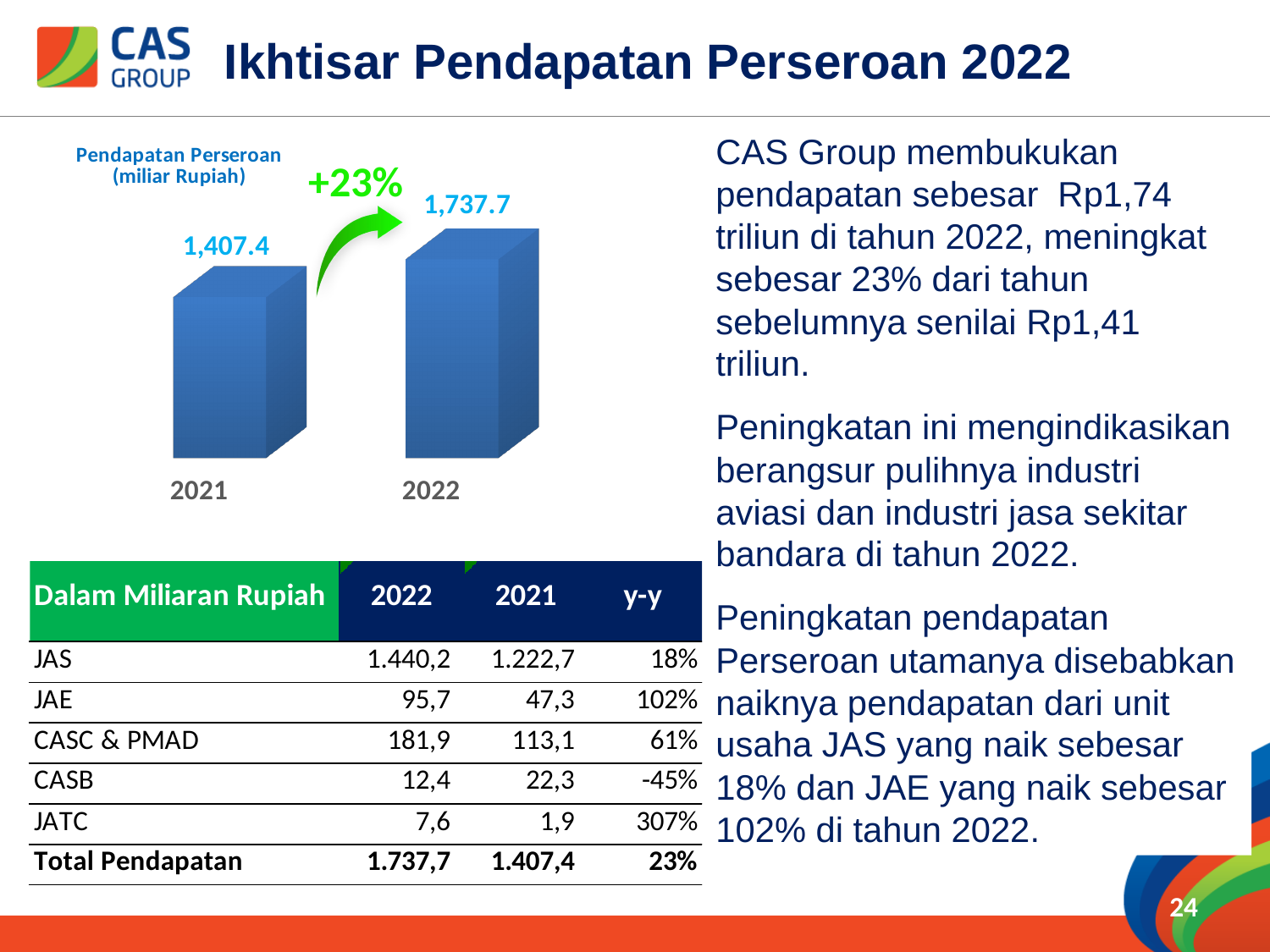
What is the value for 2021 in the Pendapatan Perseroan chart? 1,407.4 How many bars are shown in the Pendapatan Perseroan chart? 2 What is the difference between the 2022 and 2021 values in the Pendapatan Perseroan chart? 330.3 What kind of chart is the Pendapatan Perseroan chart? bar chart What unit is stated in the title of the Pendapatan Perseroan chart? miliar Rupiah What percentage change is annotated between the two bars in the Pendapatan Perseroan chart? +23% In the Pendapatan Perseroan chart, is the value for 2022 larger or smaller than the value for 2021? larger Which year has the highest value in the Pendapatan Perseroan chart? 2022 Which year has the lowest value in the Pendapatan Perseroan chart? 2021 Do the values in the Pendapatan Perseroan chart rise or fall from 2021 to 2022? rise What is the value for 2022 in the Pendapatan Perseroan chart? 1,737.7